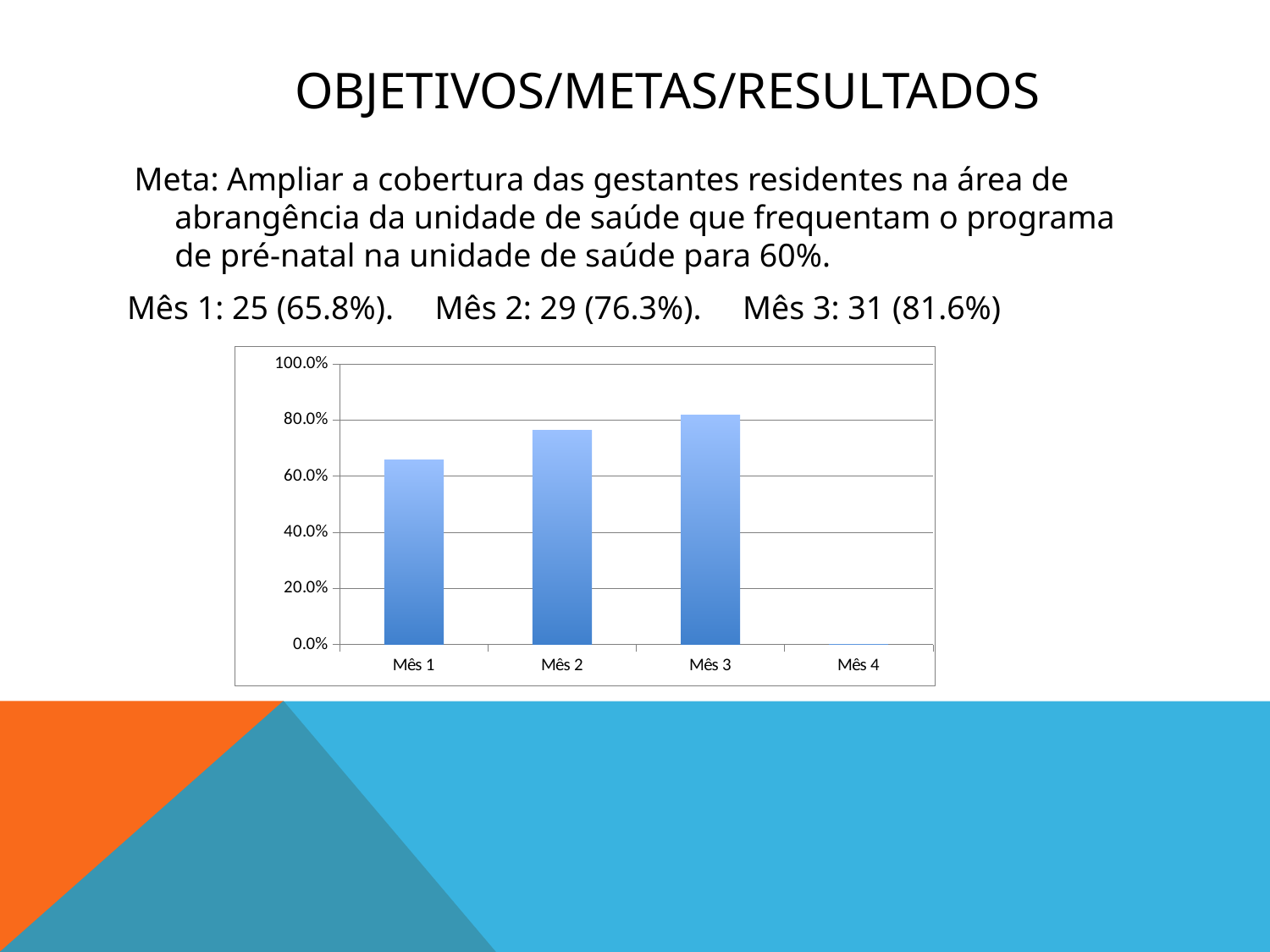
Is the value for Mês 1 greater or less than 60.0%? greater What kind of chart is shown on the slide? bar chart Is the value for Mês 2 greater or less than 80.0%? less How many bars are plotted in the chart? 3 Is the value for Mês 3 greater or less than 80.0%? greater Which month has the highest bar in the chart? Mês 3 Which is larger, the value for Mês 2 or the value for Mês 1? Mês 2 Which category on the x axis has no bar plotted? Mês 4 Which month with a plotted bar has the lowest value in the chart? Mês 1 Do the bar values rise or fall from Mês 1 to Mês 3? rise How many categories are shown on the x axis of the chart? 4 According to the slide, what percentage is shown for Mês 3? 81.6%